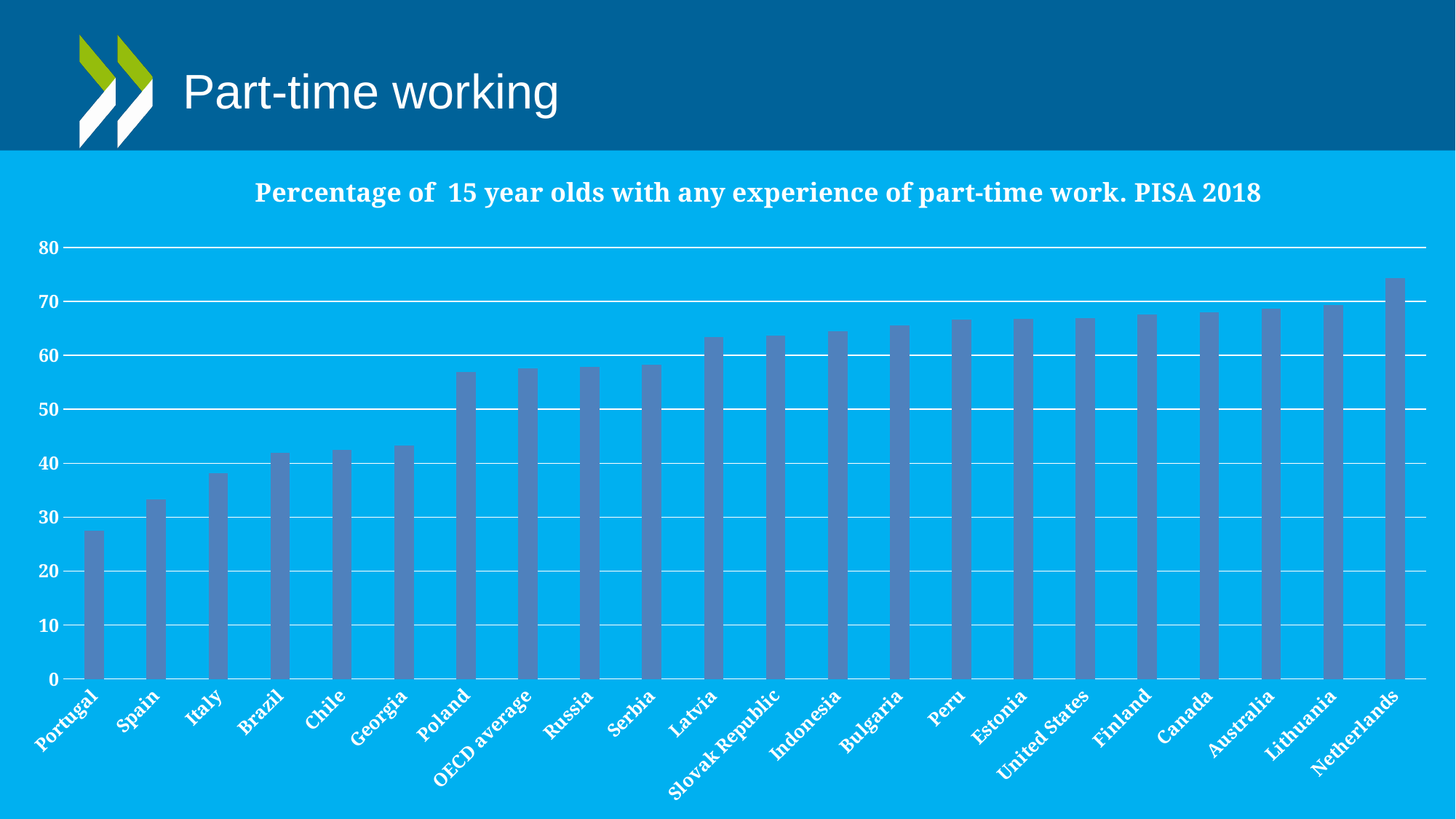
Which category has the lowest value in the chart? Portugal Is the value for Poland greater or less than 50? greater Is the value for Latvia greater or less than 60? greater Which has a larger value, Georgia or Poland? Poland Which category has the highest value in the chart? Netherlands Do the values generally rise or fall moving from left to right along the x axis? rise What is the title of the chart? Percentage of 15 year olds with any experience of part-time work. PISA 2018 Is the value for Netherlands greater or less than 70? greater What kind of chart is shown on the slide? bar chart How many countries or categories are shown on the x axis of the chart? 22